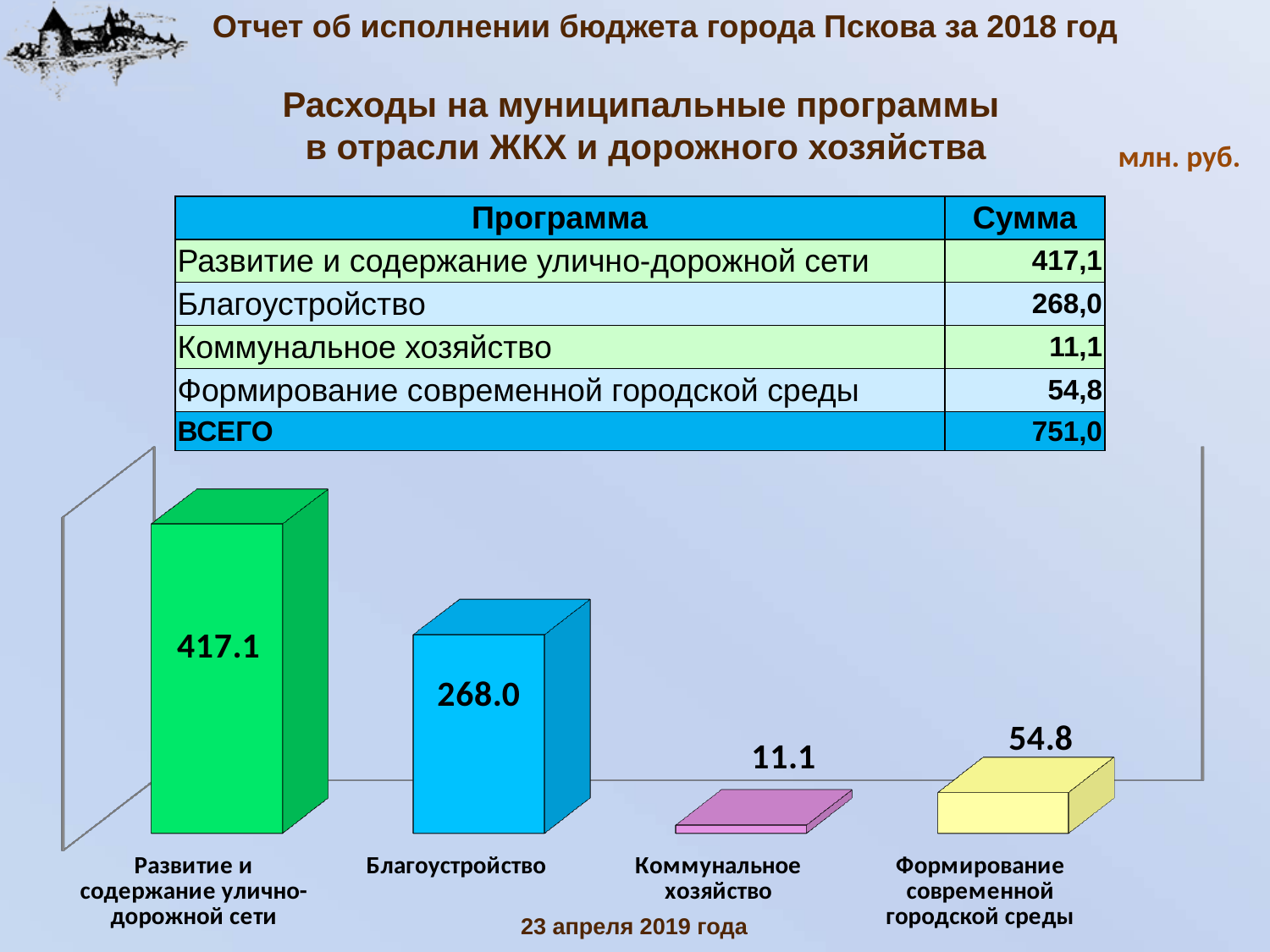
Which category has the highest value in the bar chart? Развитие и содержание улично-дорожной сети What is the value shown for Коммунальное хозяйство in the bar chart? 11.1 What colour is the bar for Благоустройство in the chart? Blue What is the difference between the values for Развитие и содержание улично-дорожной сети and Благоустройство in the bar chart? 149.1 Which category has the lowest value in the bar chart? Коммунальное хозяйство What is the value shown for Благоустройство in the bar chart? 268.0 What is the value shown for Развитие и содержание улично-дорожной сети in the bar chart? 417.1 What kind of chart is shown on the slide? Bar chart What is the difference between the values for Формирование современной городской среды and Коммунальное хозяйство in the bar chart? 43.7 Which is larger in the bar chart: Благоустройство or Формирование современной городской среды? Благоустройство What is the value shown for Формирование современной городской среды in the bar chart? 54.8 How many categories are shown in the bar chart? 4